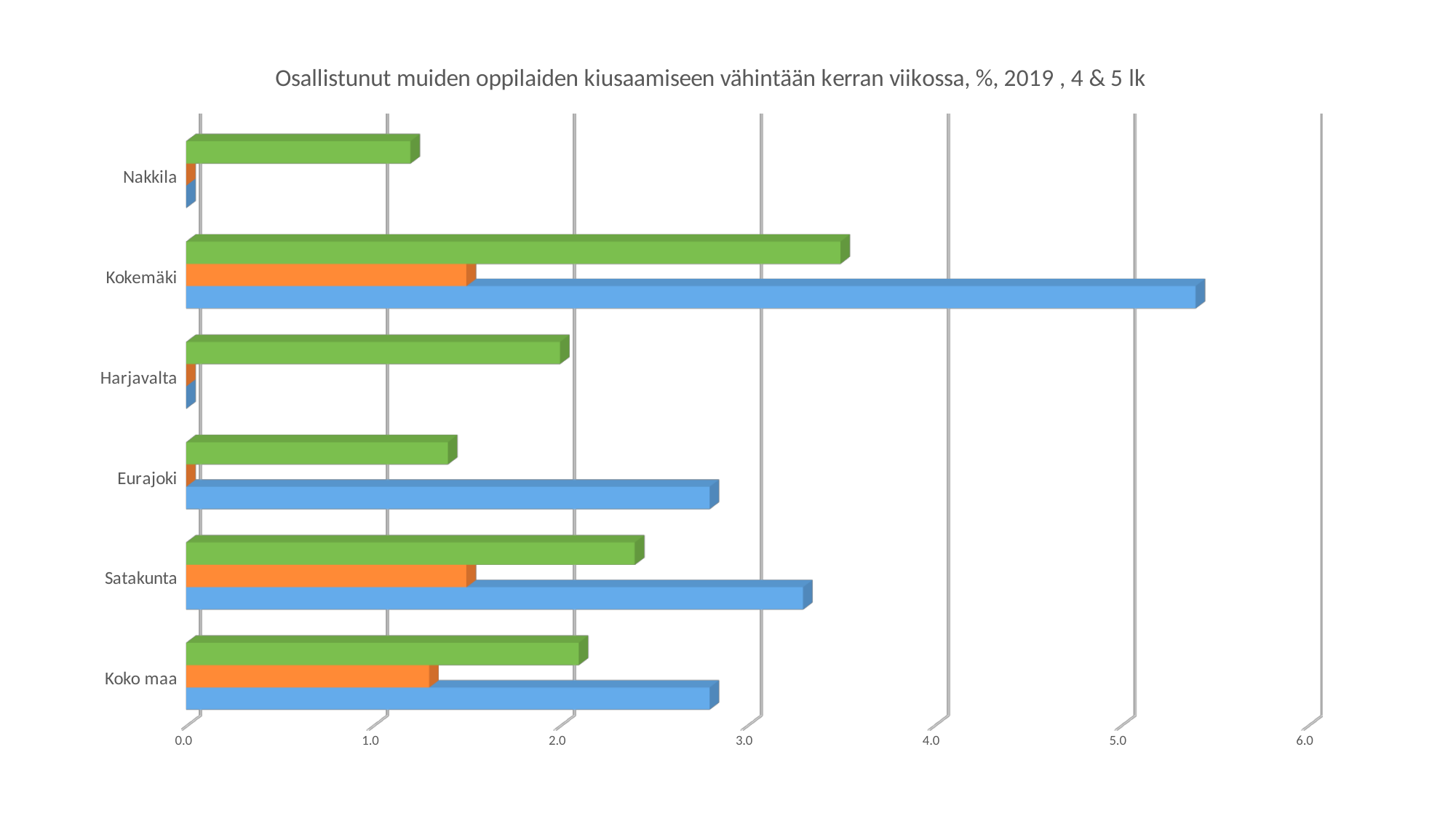
What is the title of the chart? Osallistunut muiden oppilaiden kiusaamiseen vähintään kerran viikossa, %, 2019 , 4 & 5 lk Which category has the shortest green bar? Nakkila Is the blue bar for Kokemäki greater or less than 5.0? greater What kind of chart is shown on the slide? bar chart Which is larger, the blue bar for Kokemäki or the blue bar for Satakunta? Kokemäki Is the blue bar for Satakunta greater or less than 3.0? greater How many categories (areas) are listed on the vertical axis of the chart? 6 Which category has the longest bar in the chart? Kokemäki Which category has the longest green bar? Kokemäki Which is larger, the green bar for Satakunta or the green bar for Koko maa? Satakunta Is the green bar for Kokemäki greater or less than 3.0? greater